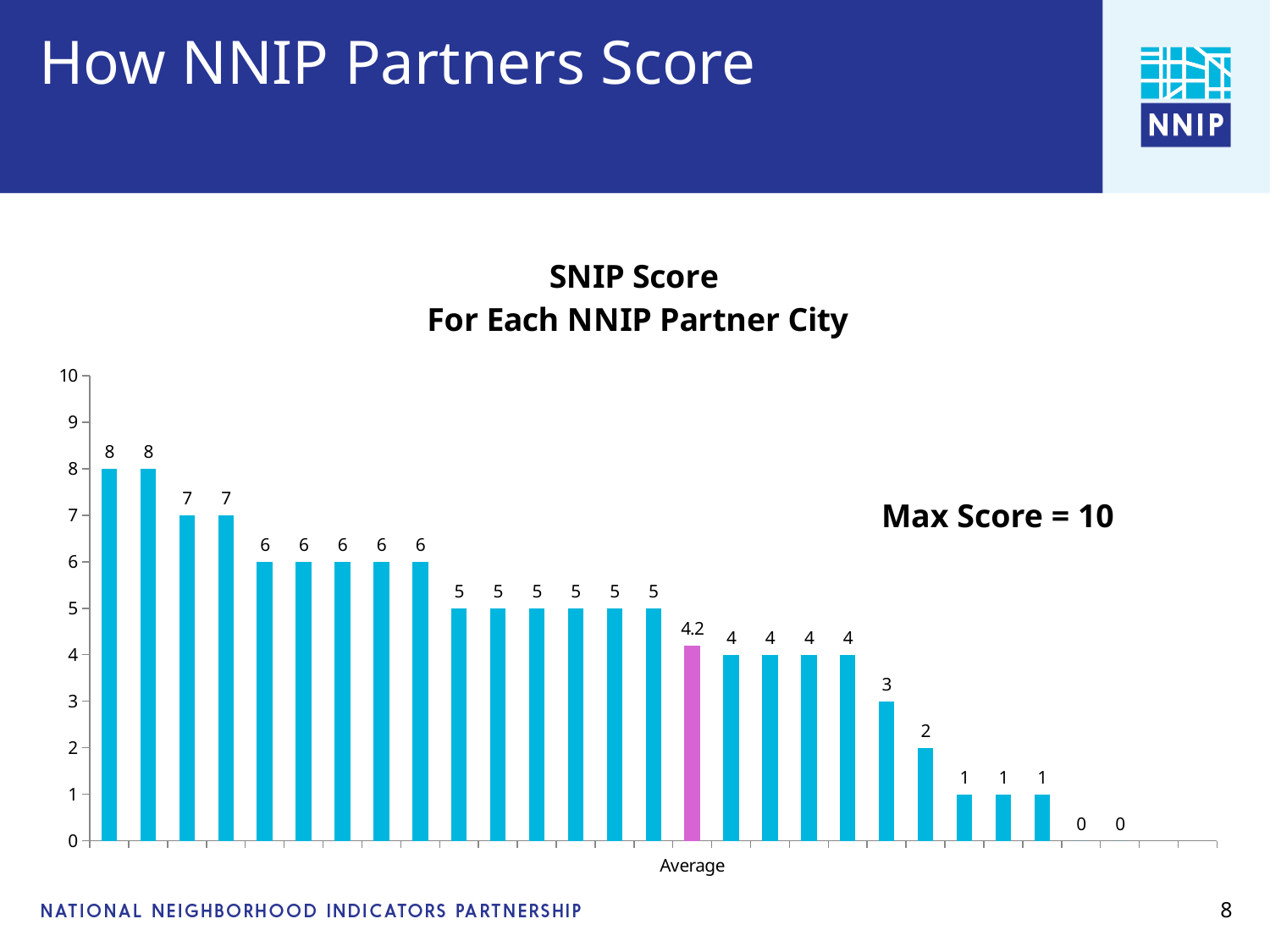
How many bars have a value of 5? 6 Is the Average bar higher or lower than the tallest bars on the chart? Lower What is the lowest SNIP score shown on the chart? 0 How many bars have a value of 0? 2 What is the value of the bar labeled "Average"? 4.2 Do the bar values rise or fall from left to right along the x axis? Fall What is the title of the chart? SNIP Score For Each NNIP Partner City What is the difference between the highest score (8) and the Average bar (4.2)? 3.8 What is the highest SNIP score shown on the chart? 8 What colour is the Average bar, which differs from the other bars? Pink/purple What kind of chart is shown on the slide? Bar chart How many bars are plotted on the chart, including the Average bar? 27